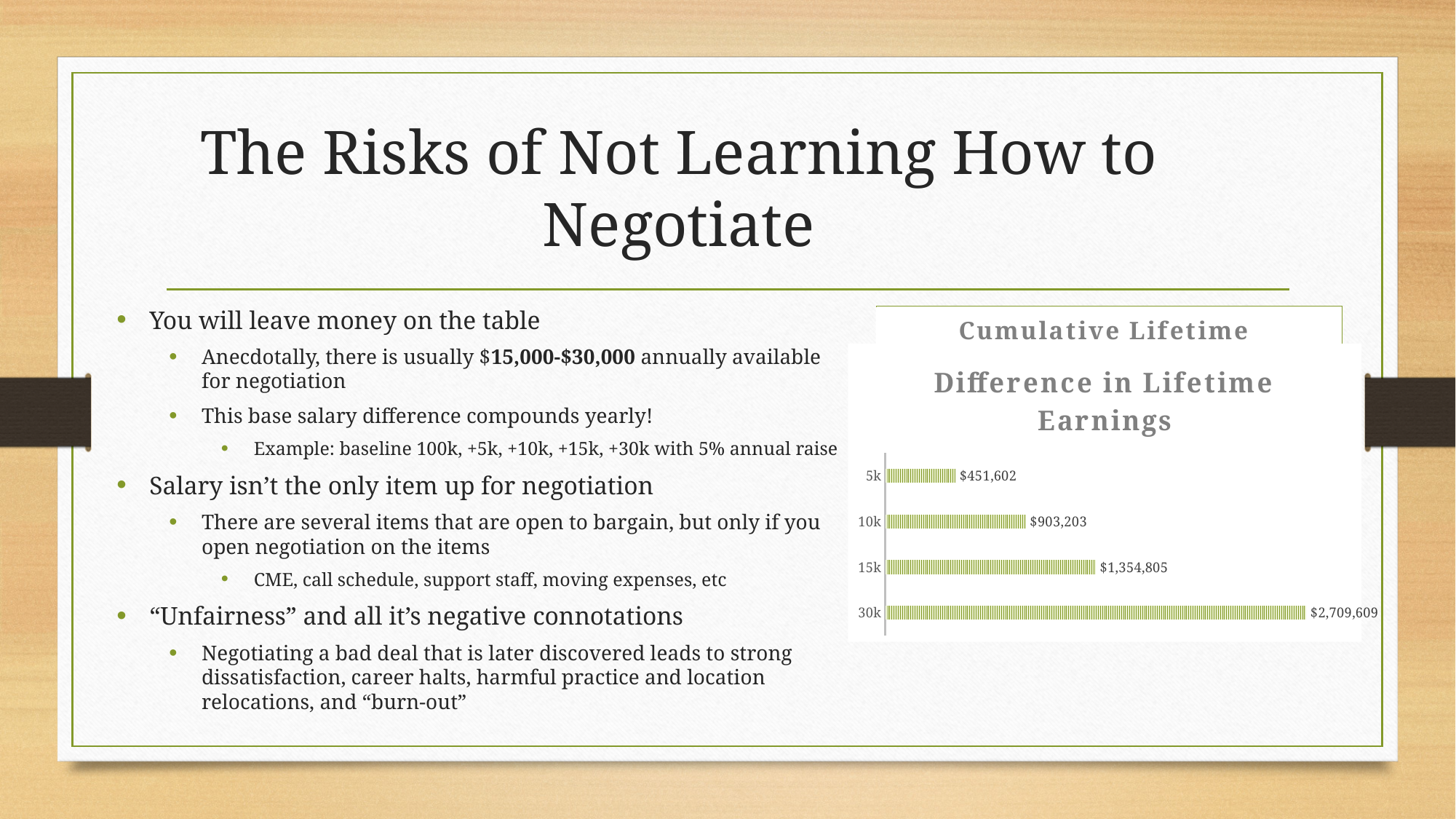
What is the difference in lifetime earnings shown for the 30k category? $2,709,609 How much larger is the value for 30k than the value for 15k? $1,354,804 What is the title of the chart? Difference in Lifetime Earnings Which is larger, the value for 15k or the value for 10k? 15k What is the difference in lifetime earnings shown for the 10k category? $903,203 How many categories are plotted in the chart? 4 Which category has the lowest difference in lifetime earnings? 5k Which category has the highest difference in lifetime earnings? 30k What is the difference in lifetime earnings shown for the 5k category? $451,602 What kind of chart is shown on the slide? Bar chart What is the difference between the values for 10k and 5k? $451,601 What is the difference in lifetime earnings shown for the 15k category? $1,354,805